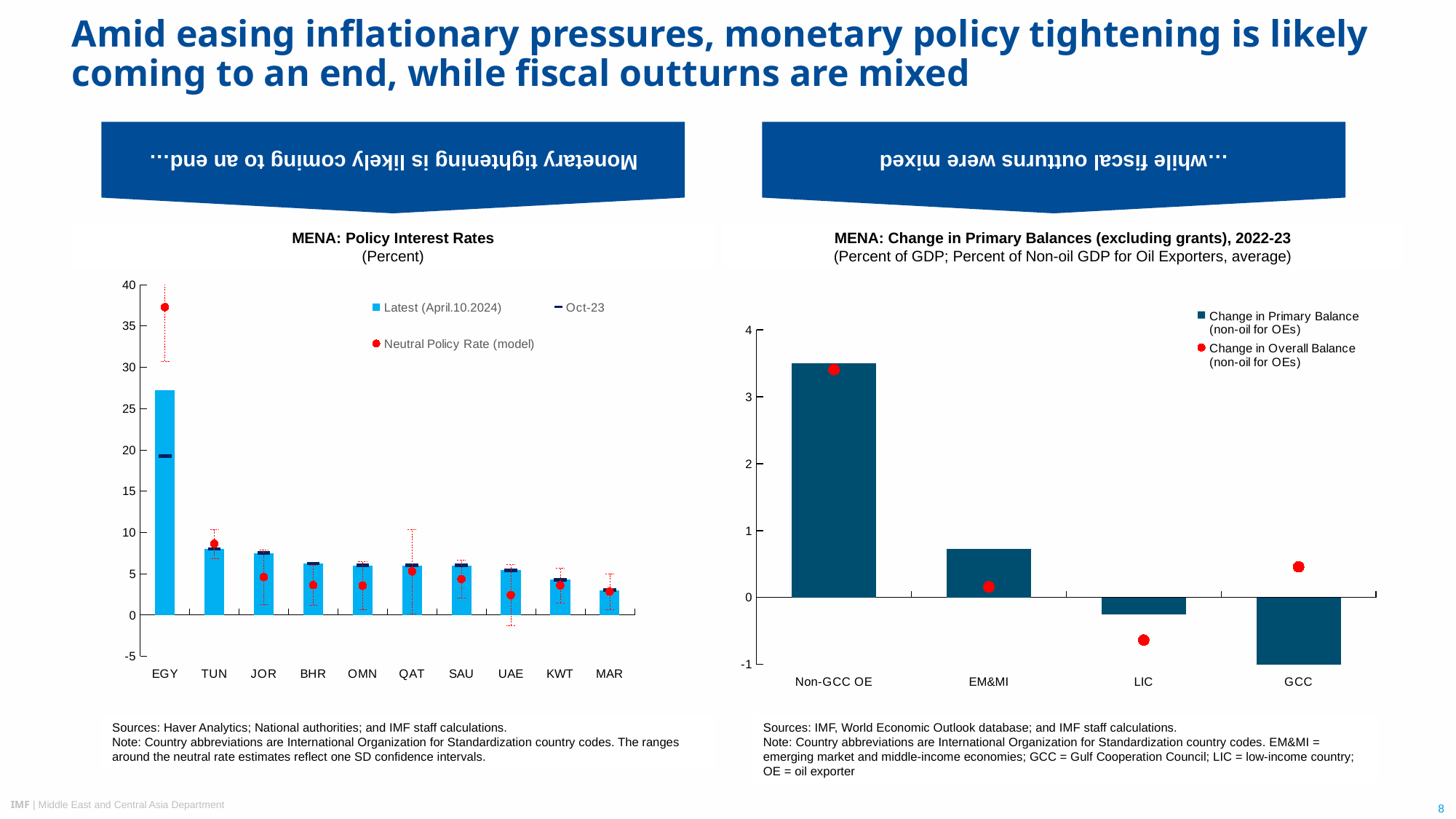
In the chart titled "MENA: Change in Primary Balances (excluding grants), 2022-23", which group has the lowest Change in Primary Balance? GCC In the chart titled "MENA: Policy Interest Rates", how many countries are shown on the x axis? 10 In the chart titled "MENA: Policy Interest Rates", is the Latest (April.10.2024) value for EGY greater or less than 25? greater In the chart titled "MENA: Change in Primary Balances (excluding grants), 2022-23", which group has the highest Change in Primary Balance? Non-GCC OE In the chart titled "MENA: Change in Primary Balances (excluding grants), 2022-23", is the Change in Primary Balance for Non-GCC OE greater or less than 3? greater In the chart titled "MENA: Policy Interest Rates", what kind of chart is used? bar chart In the chart titled "MENA: Change in Primary Balances (excluding grants), 2022-23", how many country groups are shown on the x axis? 4 In the chart titled "MENA: Policy Interest Rates", how many entries does the legend list? 3 In the chart titled "MENA: Policy Interest Rates", which has the larger Latest (April.10.2024) value, EGY or TUN? EGY In the chart titled "MENA: Policy Interest Rates", which country has the highest Latest (April.10.2024) policy rate? EGY In the chart titled "MENA: Policy Interest Rates", which country has the lowest Latest (April.10.2024) policy rate? MAR In the chart titled "MENA: Policy Interest Rates", is the Latest (April.10.2024) value for MAR greater or less than 5? less